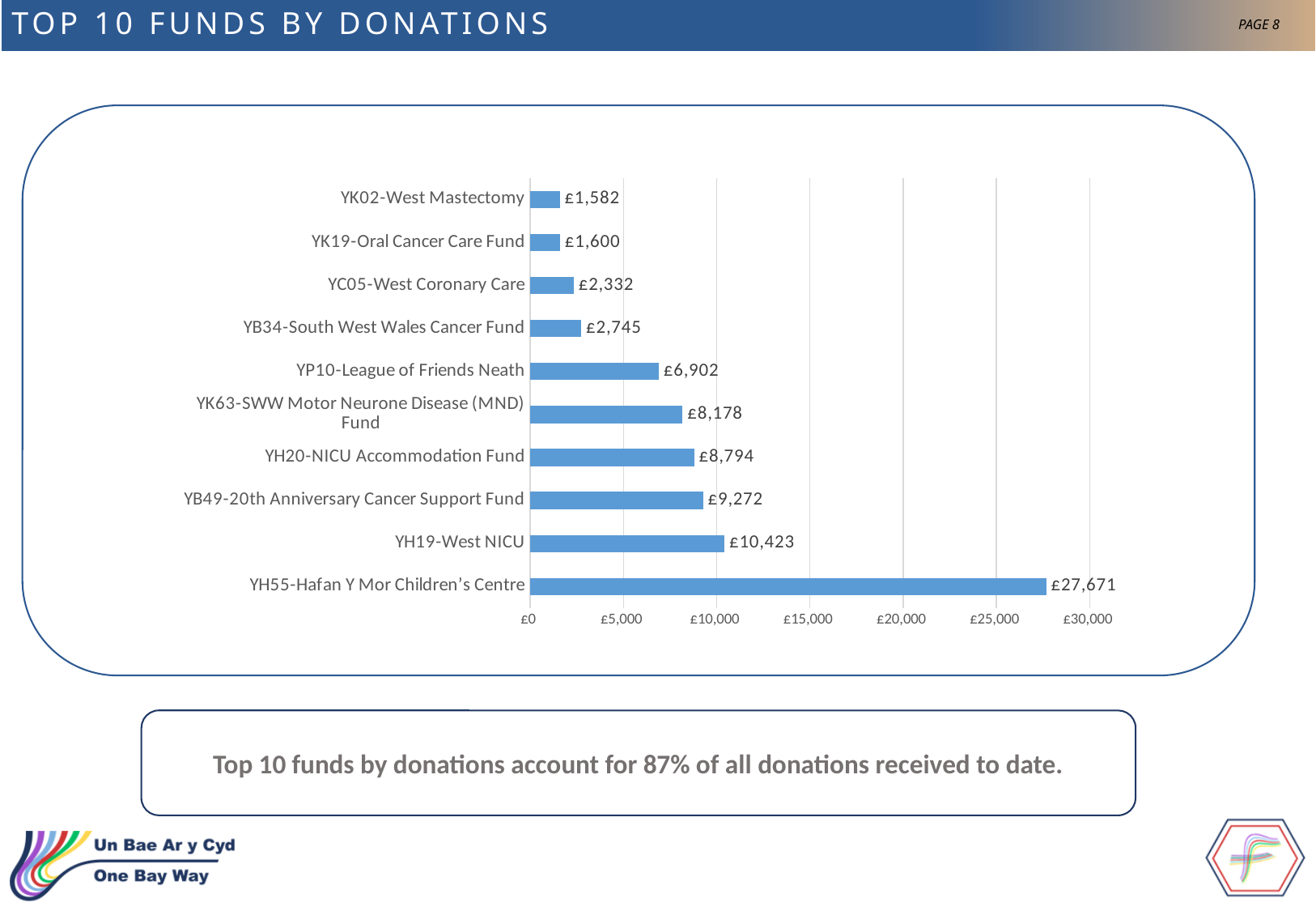
How many funds are shown in the chart? 10 What is the donation value for YK63-SWW Motor Neurone Disease (MND) Fund? £8,178 What is the difference between the donations for YH55-Hafan Y Mor Children's Centre and YH19-West NICU? £17,248 Which fund has the highest donation value? YH55-Hafan Y Mor Children's Centre What is the difference between the donations for YB49-20th Anniversary Cancer Support Fund and YH20-NICU Accommodation Fund? £478 Is the value for YH55-Hafan Y Mor Children's Centre greater or less than £25,000? greater What is the title of the slide containing the chart? TOP 10 FUNDS BY DONATIONS Which fund has the lowest donation value? YK02-West Mastectomy Which has a larger donation value, YC05-West Coronary Care or YB34-South West Wales Cancer Fund? YB34-South West Wales Cancer Fund What kind of chart is shown on the slide? bar chart What is the donation value for YP10-League of Friends Neath? £6,902 What is the donation value for YH19-West NICU? £10,423